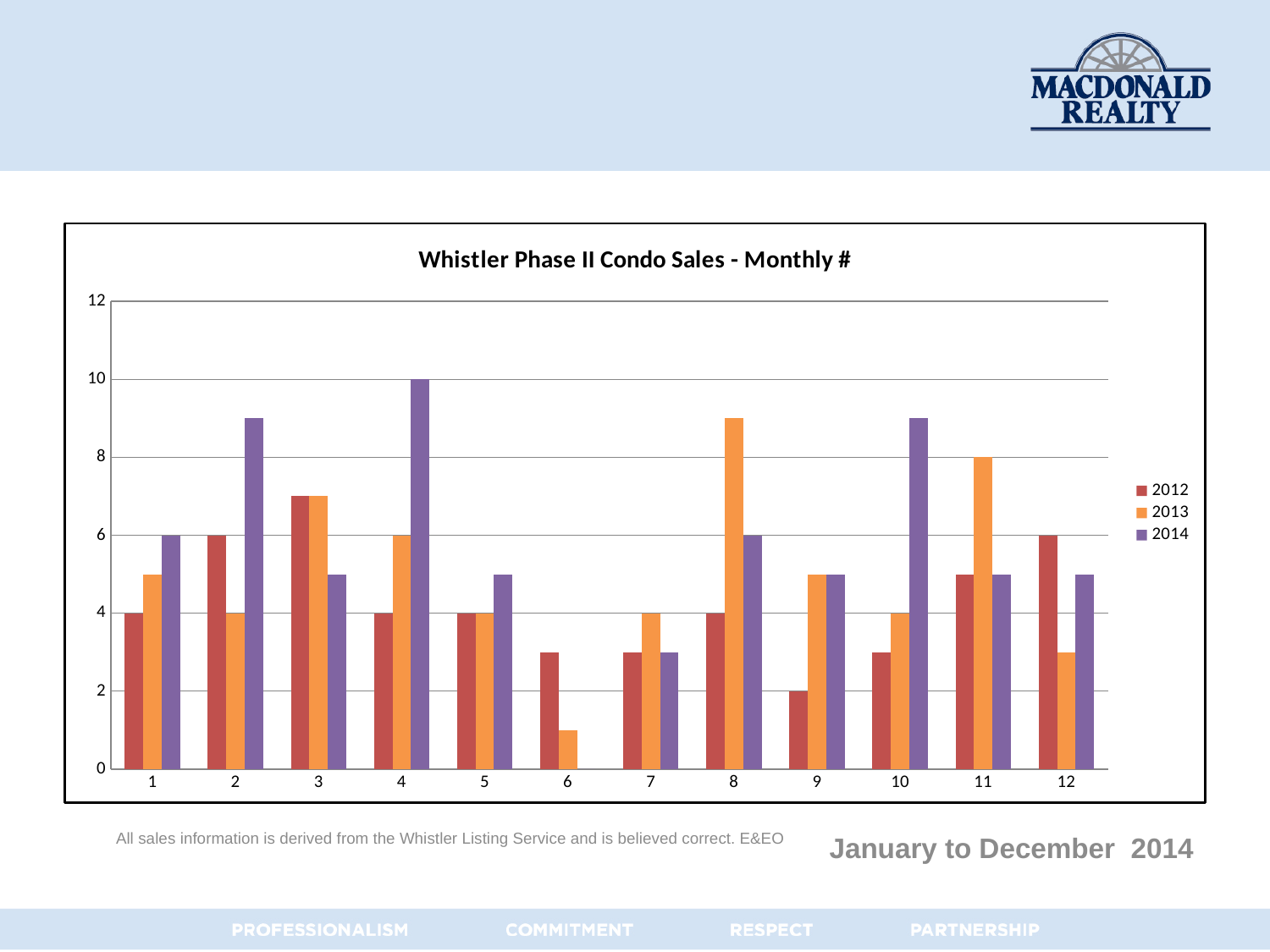
What is the 2014 value for month 4? 10 How many series does the legend list? 3 What is the 2013 value for month 11? 8 What type of chart is shown on the slide? bar chart Which month has the lowest 2013 value? 6 How many months (categories) are shown on the x axis? 12 Which is larger for month 10: the 2013 value or the 2014 value? 2014 Is the 2013 value for month 8 greater or less than 8? greater What is the title of the chart? Whistler Phase II Condo Sales - Monthly # What is the 2012 value for month 9? 2 Which month has the highest 2014 value? 4 What is the 2012 value for month 12? 6